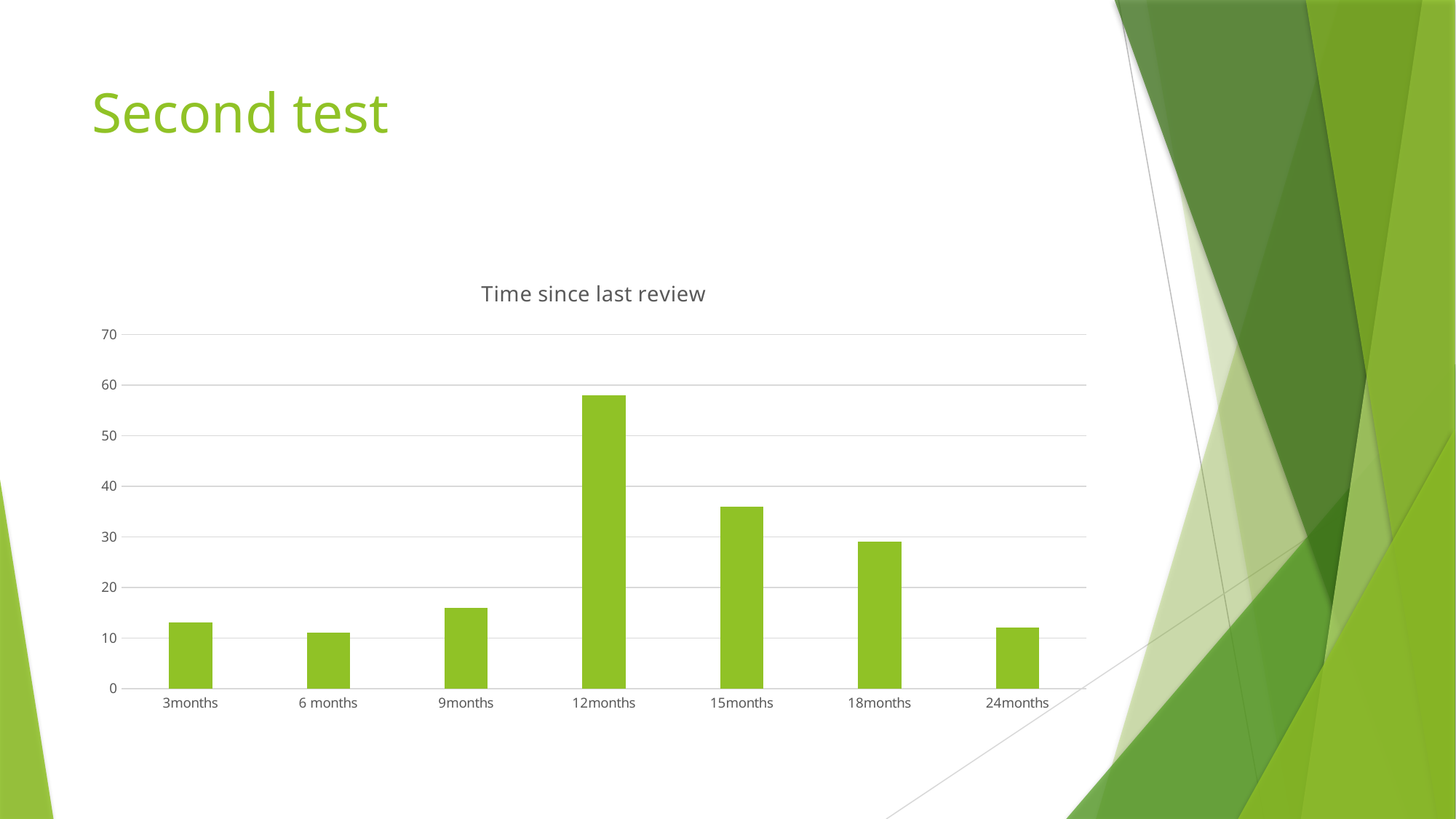
Is the value for 9months greater or less than 20? less What kind of chart is shown on the slide? bar chart Which category has the highest value in the chart? 12months What is the title of the chart? Time since last review Is the value for 12months greater or less than 50? greater Is the value for 18months greater or less than 20? greater How many categories are shown on the x axis of the chart? 7 Which is larger, the value for 15months or the value for 18months? 15months Which is larger, the value for 12months or the value for 15months? 12months What is the highest value shown on the y axis of the chart? 70